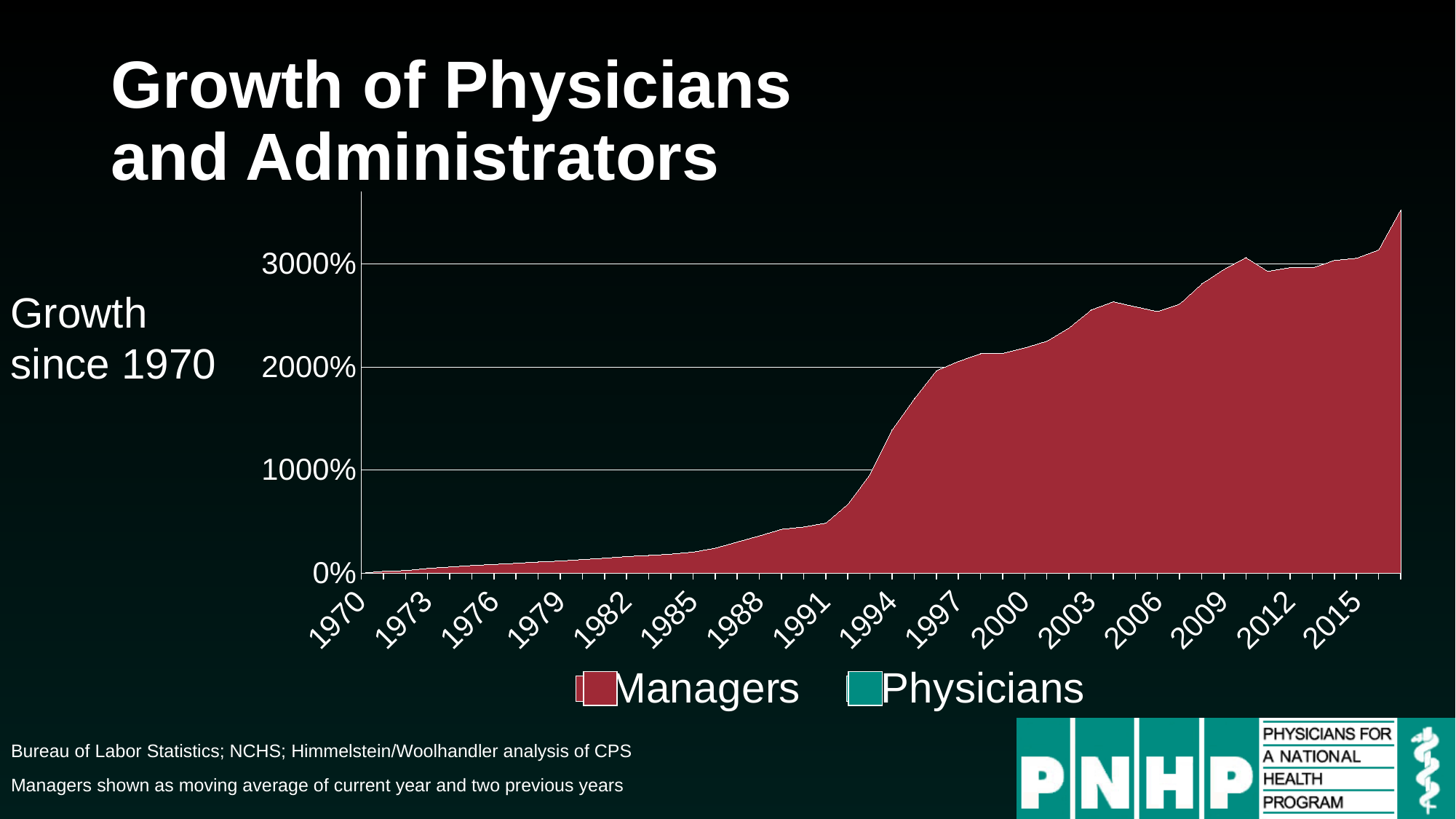
Is the Managers value for 1991 greater or less than 1000%? less Is the Managers value for 2006 greater or less than 2000%? greater Which series shows the larger growth in 2015, Managers or Physicians? Managers How many year labels are shown on the x axis? 16 How many series does the legend list? 2 Is the Managers value for 1997 greater or less than 1000%? greater What kind of chart is shown on the slide? Area chart What is the title of the chart on the slide? Growth of Physicians and Administrators What are the two series named in the legend? Managers and Physicians Does the Managers series generally rise or fall from 1970 to 2015? Rise